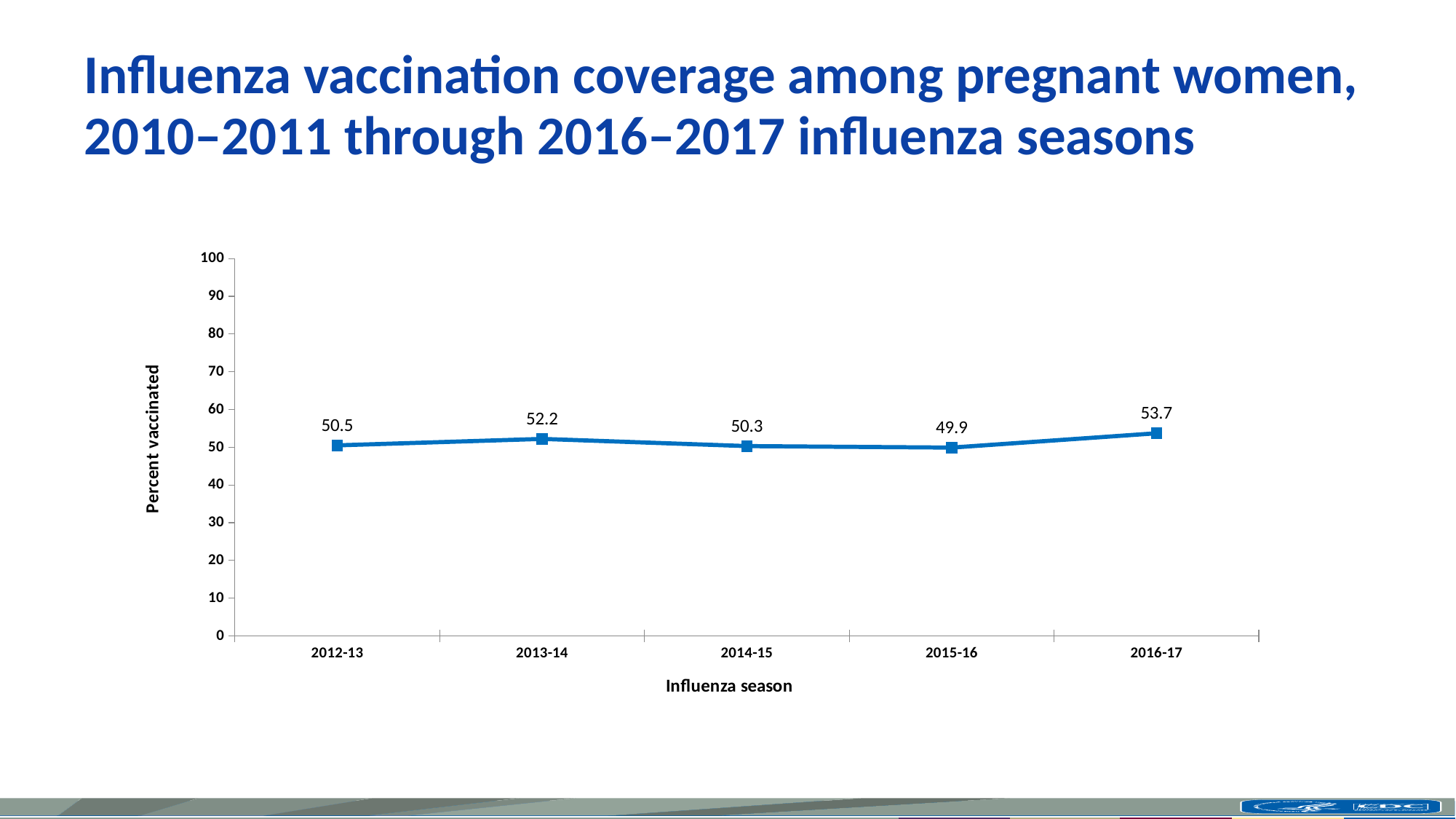
What kind of chart is shown on the slide? line chart What is the difference in percent vaccinated between the 2016-17 and 2015-16 seasons? 3.8 What is the difference in percent vaccinated between the 2013-14 and 2012-13 seasons? 1.7 Which season has a higher percent vaccinated, 2013-14 or 2014-15? 2013-14 Is the value for 2014-15 greater or less than 60? less What is the percent vaccinated for the 2015-16 influenza season? 49.9 How many influenza seasons are plotted on the chart? 5 Which influenza season has the lowest percent vaccinated? 2015-16 Which influenza season has the highest percent vaccinated? 2016-17 What is the percent vaccinated for the 2016-17 influenza season? 53.7 What is the label of the y axis? Percent vaccinated What is the percent vaccinated for the 2012-13 influenza season? 50.5